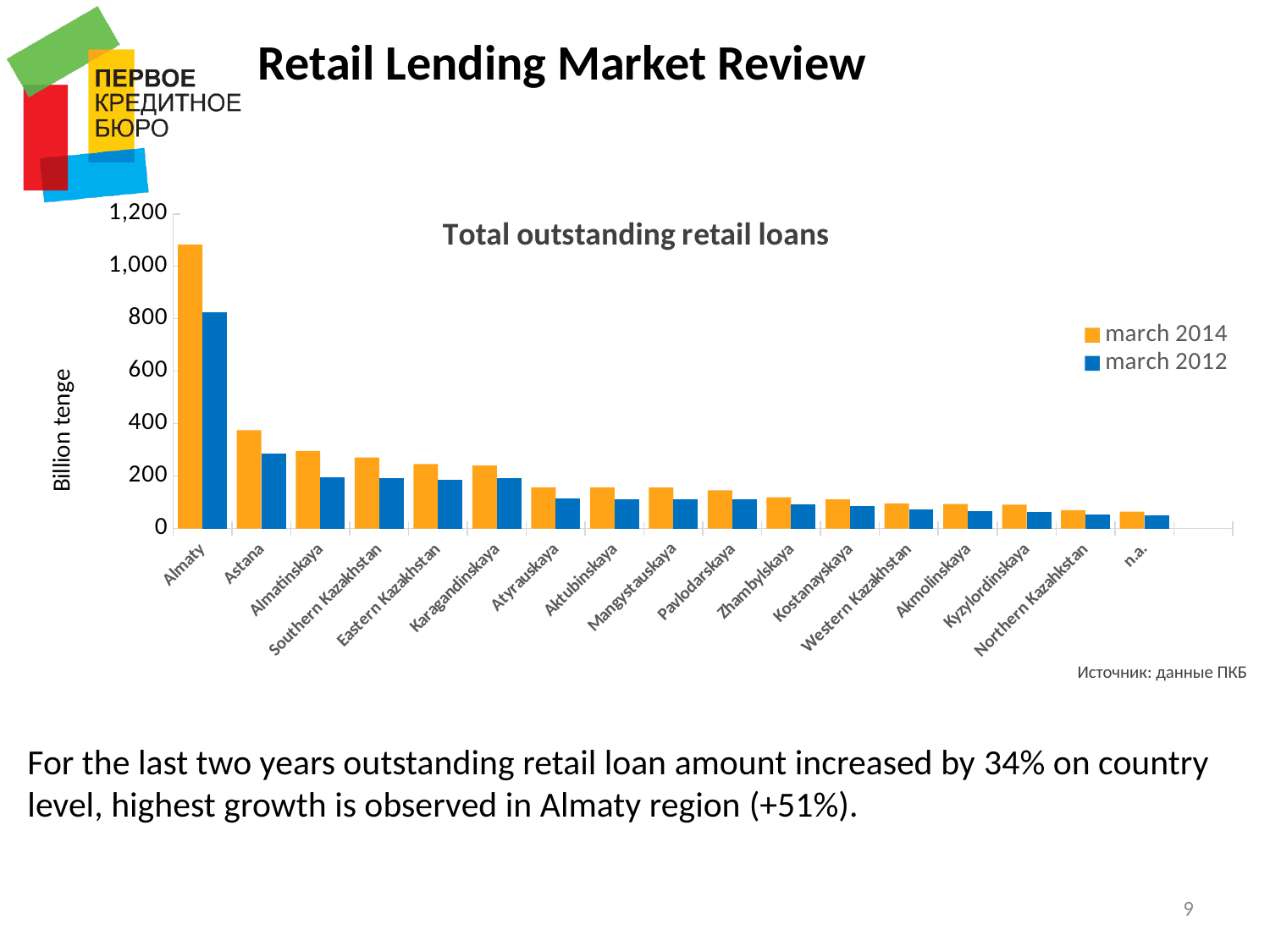
How many categories are shown on the x axis of the chart? 17 What is the label of the vertical axis? Billion tenge What is the title of the chart? Total outstanding retail loans What kind of chart is shown on the slide? bar chart Which region has the highest value for march 2014? Almaty Which is larger for march 2014: Almaty or Astana? Almaty Which region has the highest value for march 2012? Almaty Is the march 2014 value for Almaty greater or less than 1,000? greater How many series does the chart legend list? 2 Do the march 2014 values rise or fall moving from left to right along the x axis? fall Is the march 2014 value for Astana greater or less than 400? less Is the march 2012 value for Almaty greater or less than 600? greater